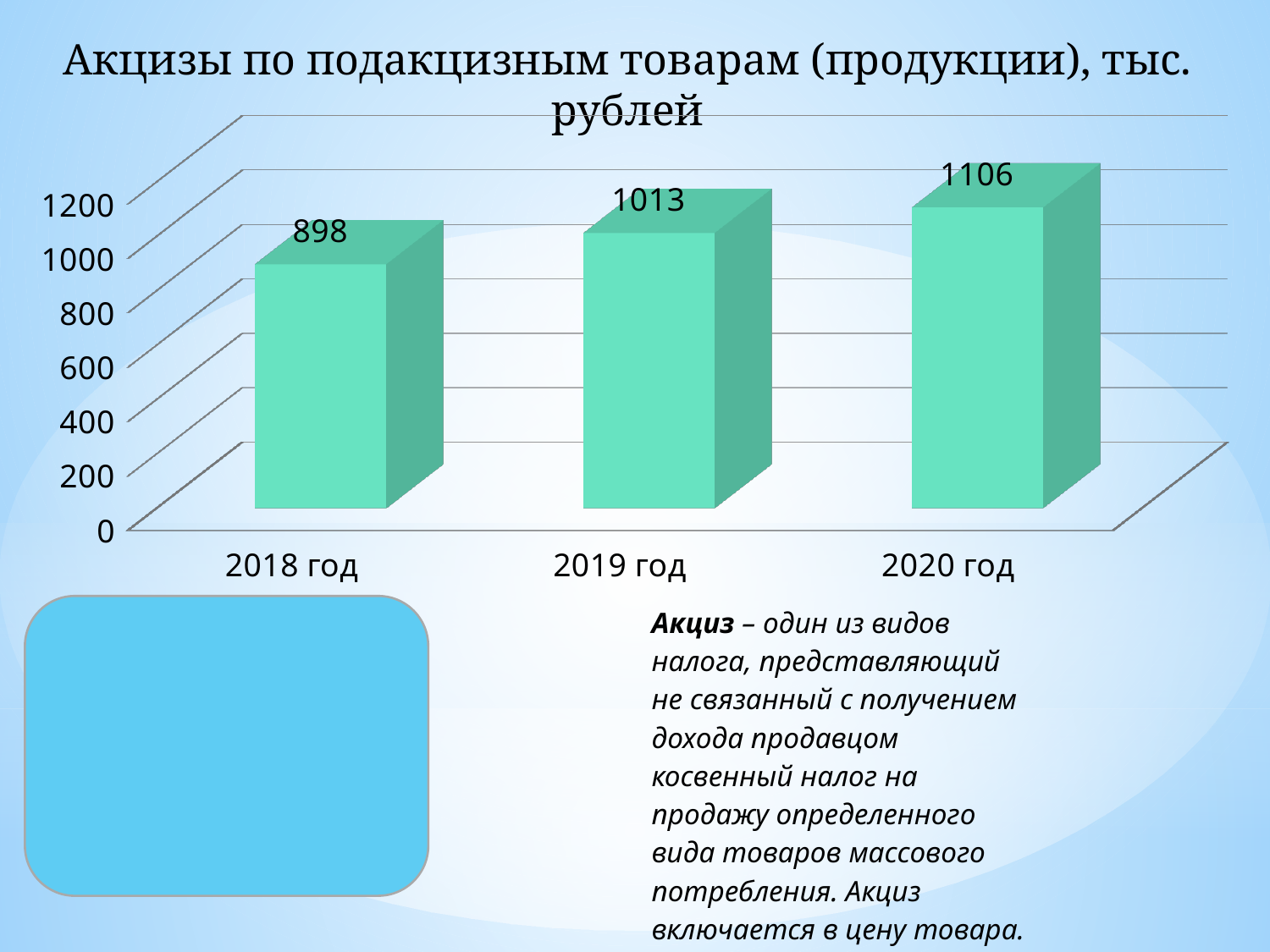
What is the difference between the values for 2019 год and 2018 год? 115 What is the difference between the values for 2020 год and 2018 год? 208 Do the values rise or fall from 2018 год to 2020 год? rise What is the value for 2019 год? 1013 Which is larger, the value for 2019 год or the value for 2020 год? 2020 год What is the value for 2018 год? 898 Is the value for 2018 год greater or less than 1000? less What kind of chart is shown on the slide? bar chart Which year has the highest value? 2020 год What is the value for 2020 год? 1106 How many categories are shown on the chart? 3 Which year has the lowest value? 2018 год